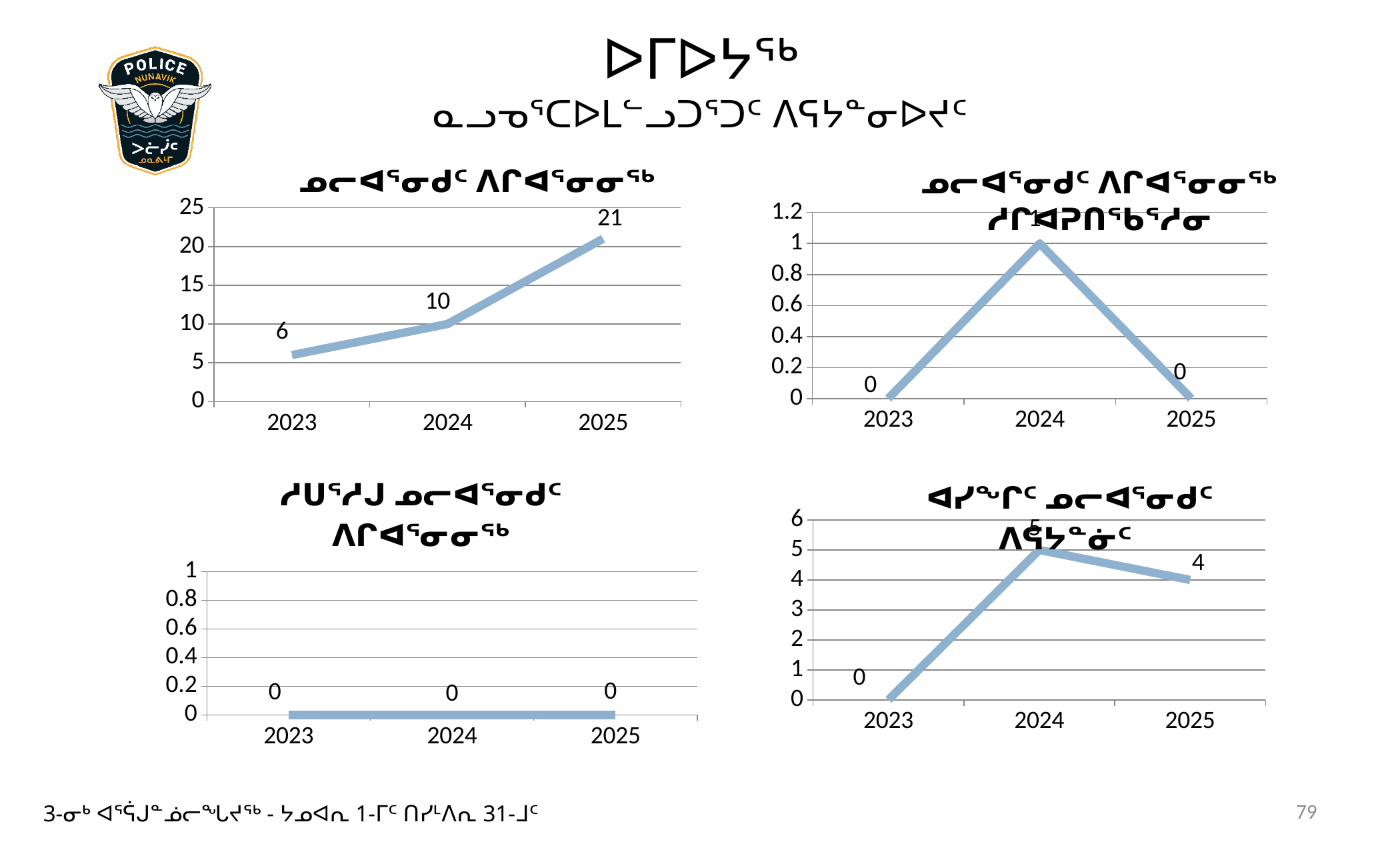
In the bottom-right chart, which is larger, the value for 2024 or the value for 2025? 2024 In the top-left chart, what is the value for 2023? 6 In the bottom-right chart, what is the value for 2025? 4 How many years are plotted in the bottom-left chart? 3 In the top-right chart, which year has the highest value? 2024 In the top-left chart, what is the difference between the 2025 and 2024 values? 11 In the top-left chart, what is the value for 2025? 21 In the top-right chart, what is the value for 2025? 0 In the top-left chart, do the values rise or fall from 2023 to 2025? rise What kind of chart is the top-left chart? line chart In the bottom-left chart, what is the value for 2024? 0 In the top-left chart, which year has the highest value? 2025